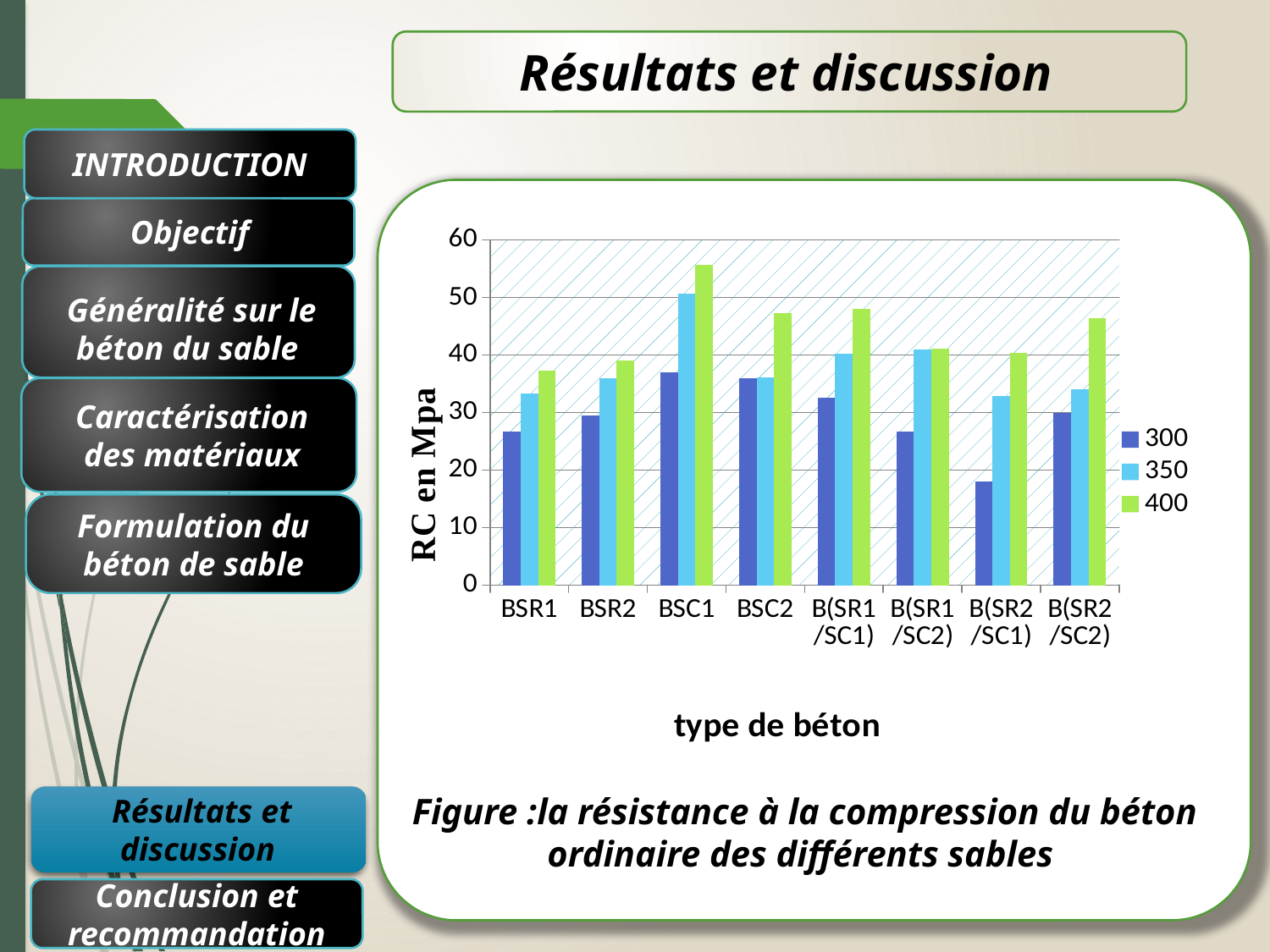
Is the value for BSC1 in the 400 series greater or less than 50? greater What kind of chart is shown on the slide? bar chart How many concrete types (categories) are shown on the x axis? 8 Which concrete type has the lowest value for the 300 series? B(SR2/SC1) Which concrete type has the highest value for the 350 series? BSC1 In the 400 series, which is larger: BSC1 or BSC2? BSC1 Is the value for BSR1 in the 400 series greater or less than 40? less How many series does the legend list? 3 Is the value for B(SR2/SC1) in the 300 series greater or less than 20? less What is the title of the y axis? RC en Mpa In the 300 series, which is larger: BSR1 or BSR2? BSR2 Which concrete type has the highest value for the 400 series? BSC1